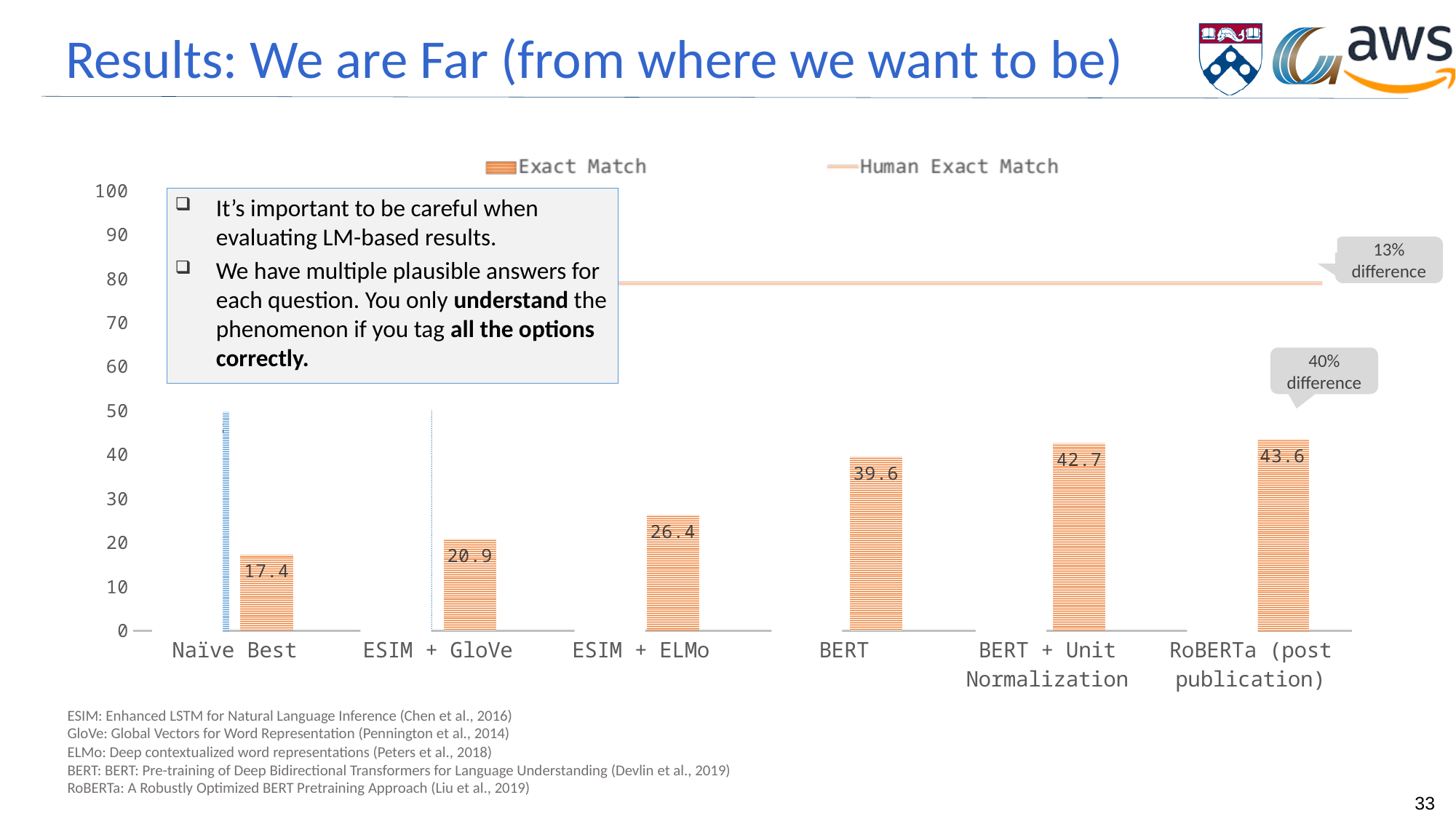
What is the Exact Match value for RoBERTa (post publication)? 43.6 Which model has the lowest Exact Match value? Naïve Best What is the Exact Match value for BERT? 39.6 Is the Human Exact Match line greater or less than 70? greater How many models are shown on the x axis of the chart? 6 Which has a higher Exact Match value, ESIM + GloVe or ESIM + ELMo? ESIM + ELMo What is the Exact Match value for ESIM + ELMo? 26.4 How many series does the chart legend list? 2 What is the difference in Exact Match between BERT + Unit Normalization and BERT? 3.1 What is the difference in Exact Match between RoBERTa (post publication) and Naïve Best? 26.2 Do the Exact Match values rise or fall from Naïve Best to RoBERTa (post publication)? rise Which model has the highest Exact Match value? RoBERTa (post publication)